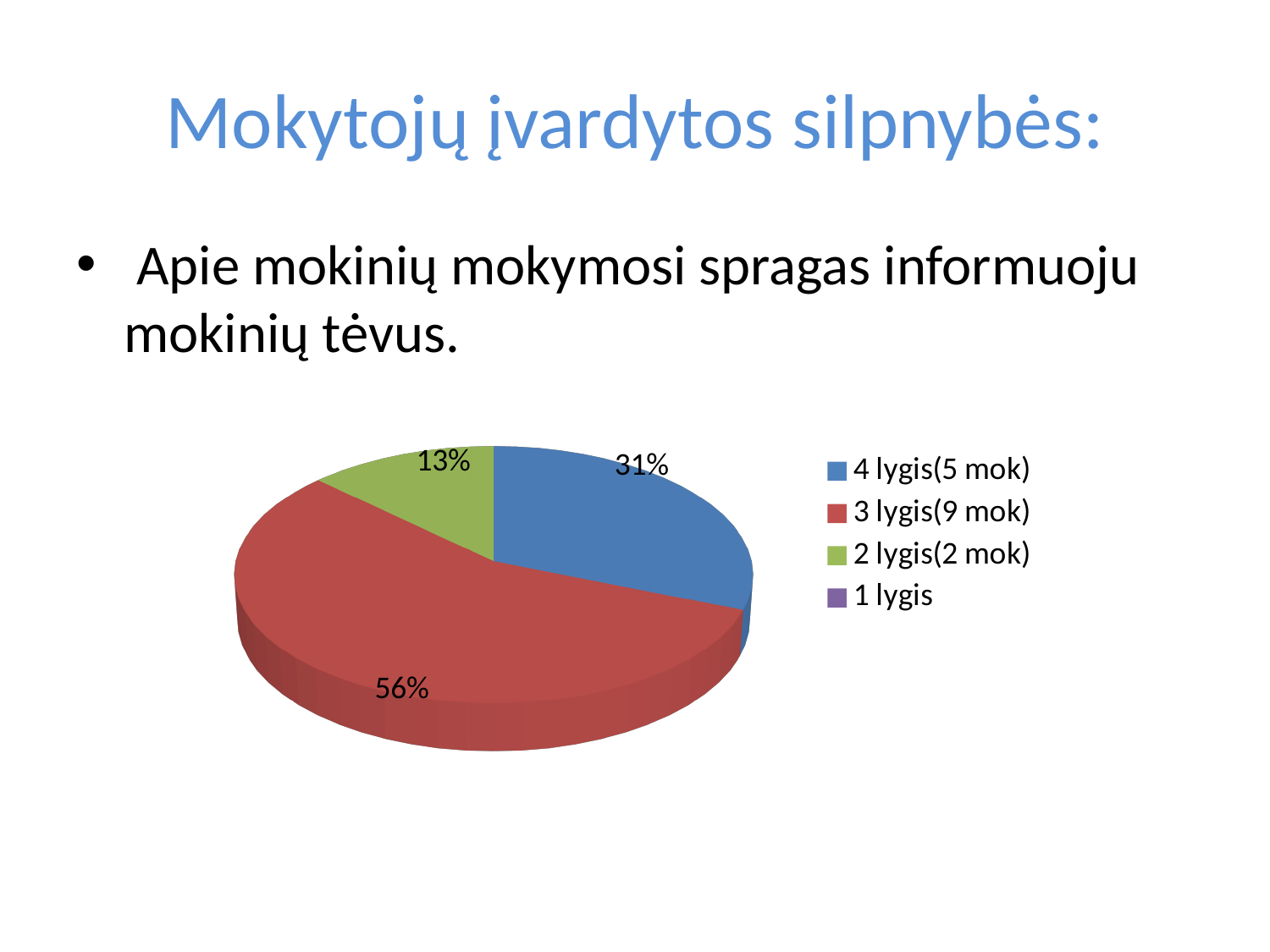
How many entries does the legend list? 4 What share of the pie does the "3 lygis(9 mok)" slice represent? 56% What share of the pie does the "2 lygis(2 mok)" slice represent? 13% What is the combined share of the "4 lygis(5 mok)" and "2 lygis(2 mok)" slices? 44% What colour is the "3 lygis(9 mok)" slice? red What kind of chart is shown on the slide? pie chart What is the difference in percentage points between the "3 lygis(9 mok)" slice and the "4 lygis(5 mok)" slice? 25 Which category has the largest slice of the pie? 3 lygis(9 mok) What colour is the "4 lygis(5 mok)" slice? blue Which slice is larger: "4 lygis(5 mok)" or "2 lygis(2 mok)"? 4 lygis(5 mok) Which of the visible slices is the smallest? 2 lygis(2 mok) What share of the pie does the "4 lygis(5 mok)" slice represent? 31%